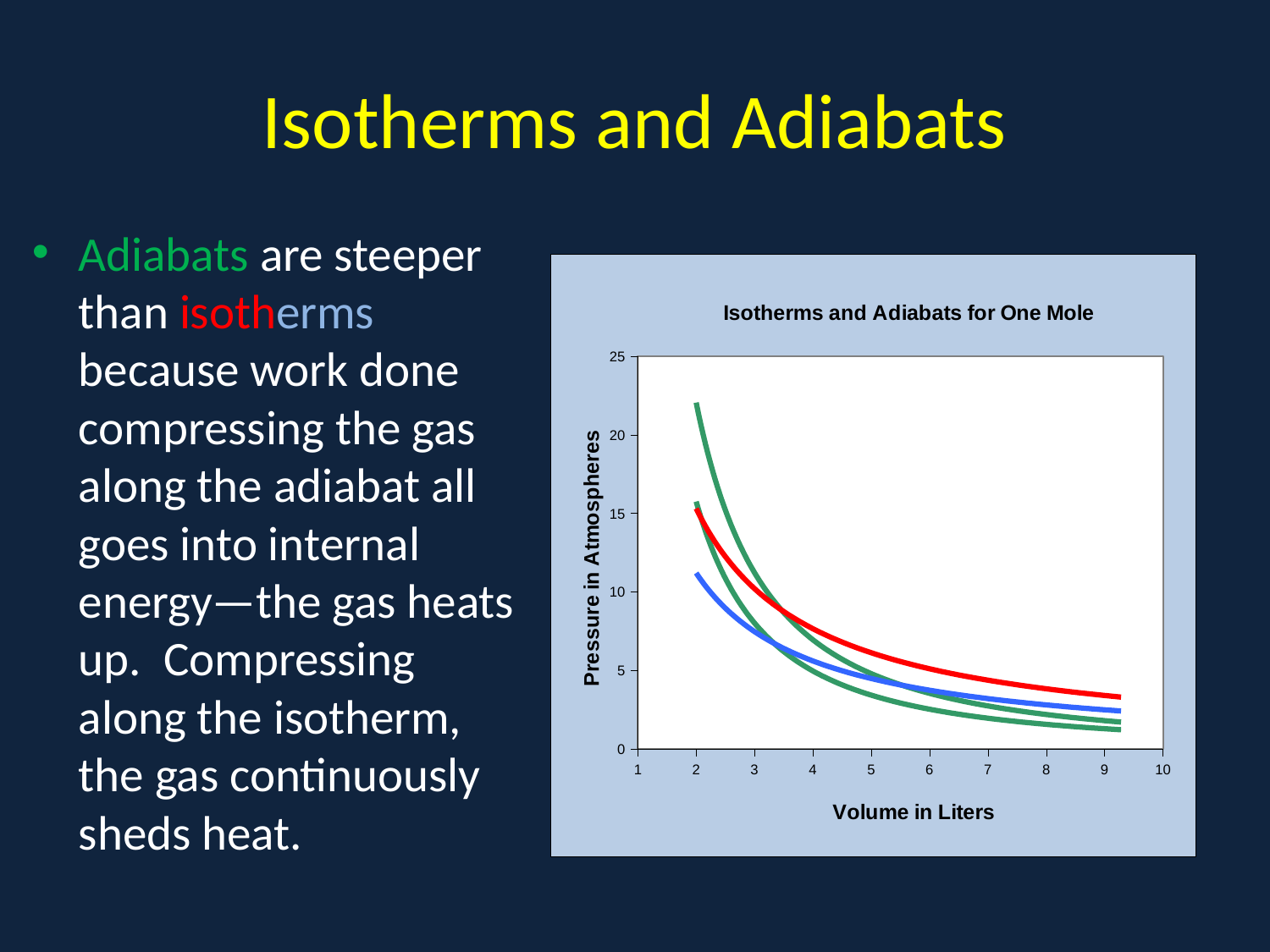
At a volume of 9 liters, which curve has the higher pressure, the red curve or the blue curve? red curve What is the highest value shown on the vertical axis of the chart? 25 What kind of chart is shown on the slide? line chart Is the pressure of the blue curve at a volume of 2 liters greater or less than 10 atmospheres? greater Is the pressure of the highest green curve at a volume of 2 liters greater or less than 20 atmospheres? greater Do the curves on the chart rise or fall as volume increases along the x axis? fall What is the title of the chart? Isotherms and Adiabats for One Mole Is the pressure of the red curve at a volume of 4 liters greater or less than 5 atmospheres? greater What is the label of the vertical axis of the chart? Pressure in Atmospheres How many curves are plotted on the chart? 4 At a volume of 2 liters, which curve has the lowest pressure? blue curve